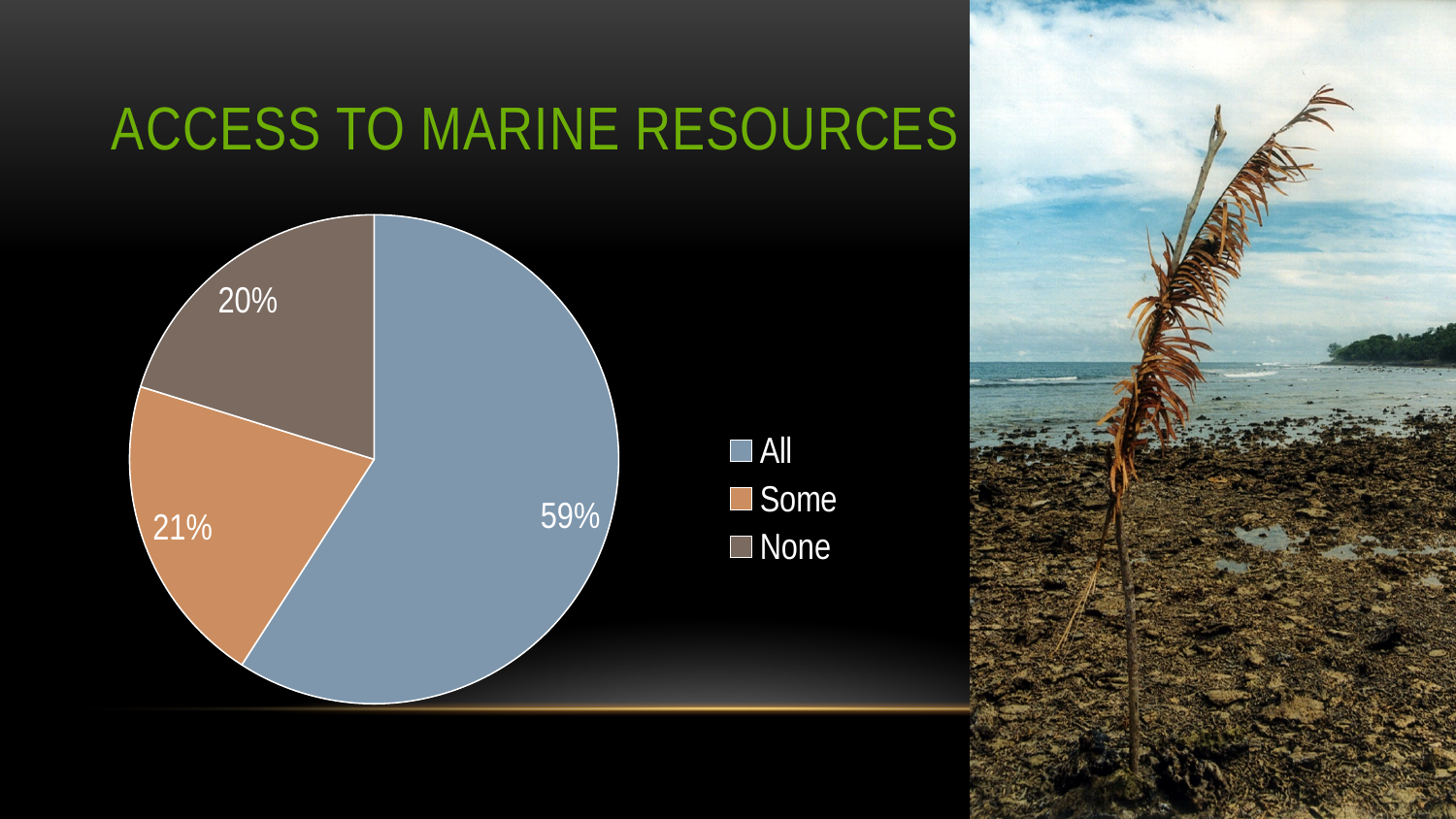
What share of the pie does the "Some" slice represent? 21% How many slices does the pie chart have? 3 What kind of chart is shown on the slide? pie chart How many entries does the legend list? 3 What is the title of the slide containing the pie chart? ACCESS TO MARINE RESOURCES Which category has the largest slice of the pie? All What is the difference in percentage points between the "Some" slice and the "None" slice? 1 What is the difference in percentage points between the "All" slice and the "Some" slice? 38 What share of the pie does the "None" slice represent? 20% Which is larger, the "All" slice or the "None" slice? All Which category has the smallest slice of the pie? None What share of the pie does the "All" slice represent? 59%